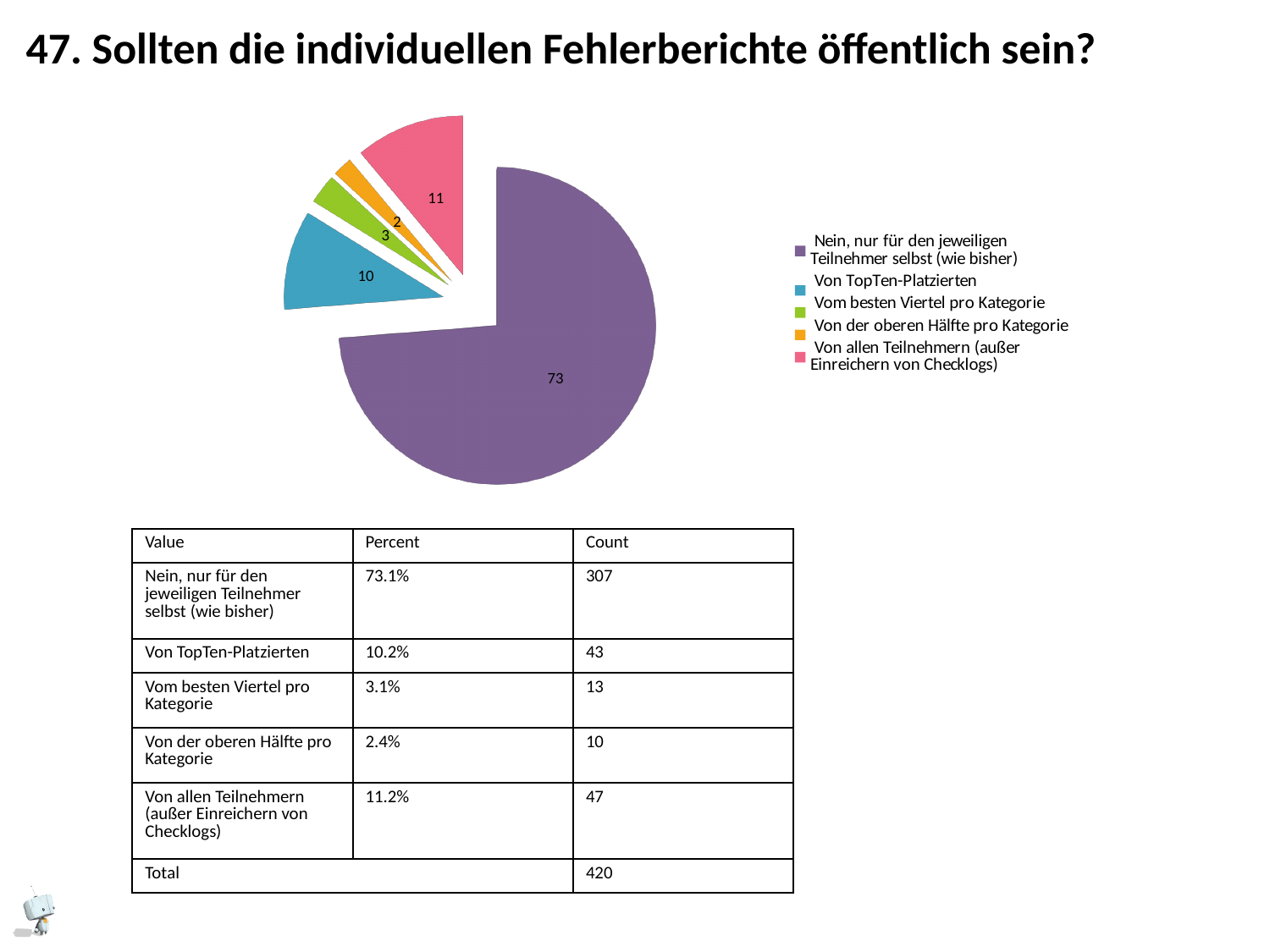
How many slices does the pie chart have? 5 What value is labelled on the pie slice for "Von TopTen-Platzierten"? 10 Which category has the smallest slice in the pie chart? Von der oberen Hälfte pro Kategorie What value is labelled on the pie slice for "Von allen Teilnehmern (außer Einreichern von Checklogs)"? 11 What value is labelled on the pie slice for "Vom besten Viertel pro Kategorie"? 3 What colour is the slice for "Von TopTen-Platzierten" in the pie chart? blue What is the difference between the labelled values of the largest slice and the "Von allen Teilnehmern (außer Einreichern von Checklogs)" slice? 62 What type of chart is shown on the slide? pie chart How many entries does the legend of the pie chart list? 5 Which slice is larger: "Von TopTen-Platzierten" or "Von allen Teilnehmern (außer Einreichern von Checklogs)"? Von allen Teilnehmern (außer Einreichern von Checklogs) Which category has the largest slice in the pie chart? Nein, nur für den jeweiligen Teilnehmer selbst (wie bisher) What value is labelled on the pie slice for "Nein, nur für den jeweiligen Teilnehmer selbst (wie bisher)"? 73